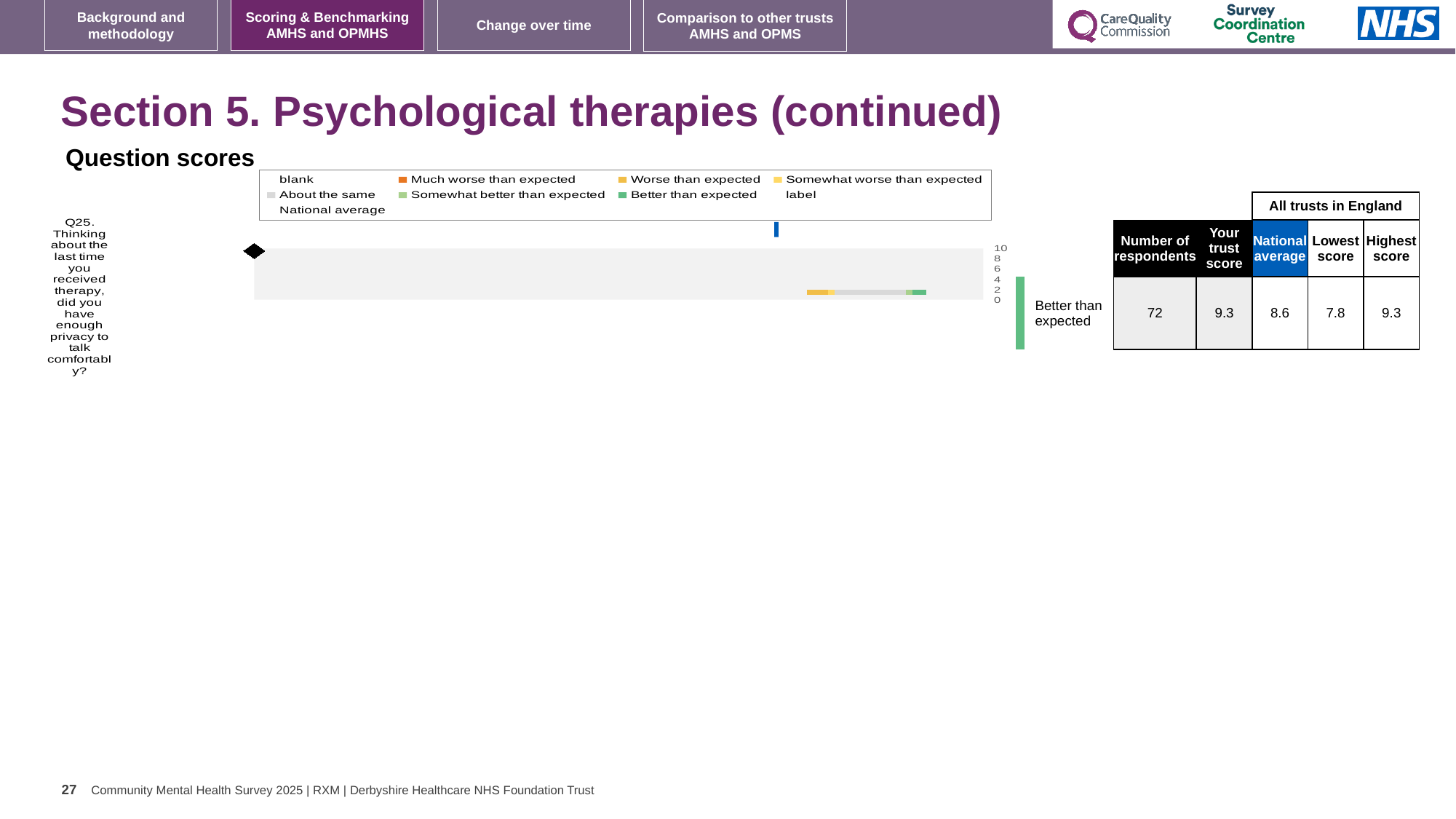
What is the lowest score among all trusts in England for Q25? 7.8 What is the national average score for Q25 in the table beside the chart? 8.6 What kind of chart is shown under 'Question scores'? bar chart What is the highest score among all trusts in England for Q25? 9.3 How many respondents answered Q25 according to the table beside the chart? 72 How many survey questions are plotted in the Question scores chart? 1 Which question number is plotted in the Question scores chart? Q25 What is the highest value shown on the chart's score axis? 10 For Q25, what is the difference between the trust's score and the national average? 0.7 What is the trust's score for Q25 in the table beside the chart? 9.3 For Q25, which is larger: the trust's score or the national average? the trust's score What benchmark rating is shown for Q25 next to the chart? Better than expected